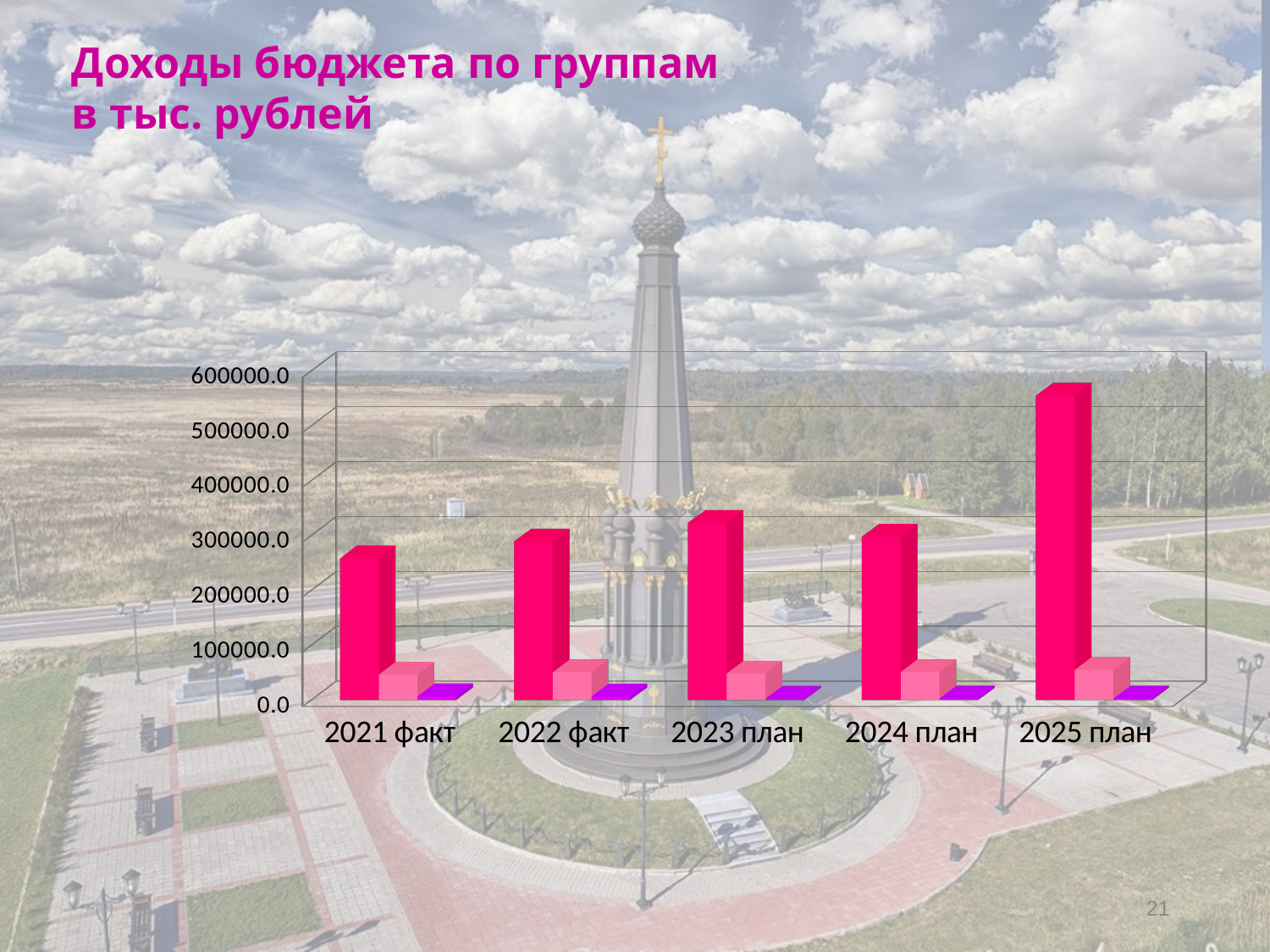
Which has the larger tallest bar, 2021 факт or 2023 план? 2023 план Is the tallest bar for 2021 факт greater or less than 300000.0? less Which has the larger tallest bar, 2025 план or 2024 план? 2025 план How many categories are shown along the x axis of the chart? 5 Is the tallest bar for 2023 план greater or less than 300000.0? greater Is the tallest bar for 2021 факт greater or less than 200000.0? greater Which category has the tallest bar in the chart? 2025 план Among the tallest (magenta) bars, which category has the lowest value? 2021 факт What kind of chart is shown on the slide? bar chart How many bars are plotted for each category in the chart? 3 What is the title of the chart on the slide? Доходы бюджета по группам в тыс. рублей